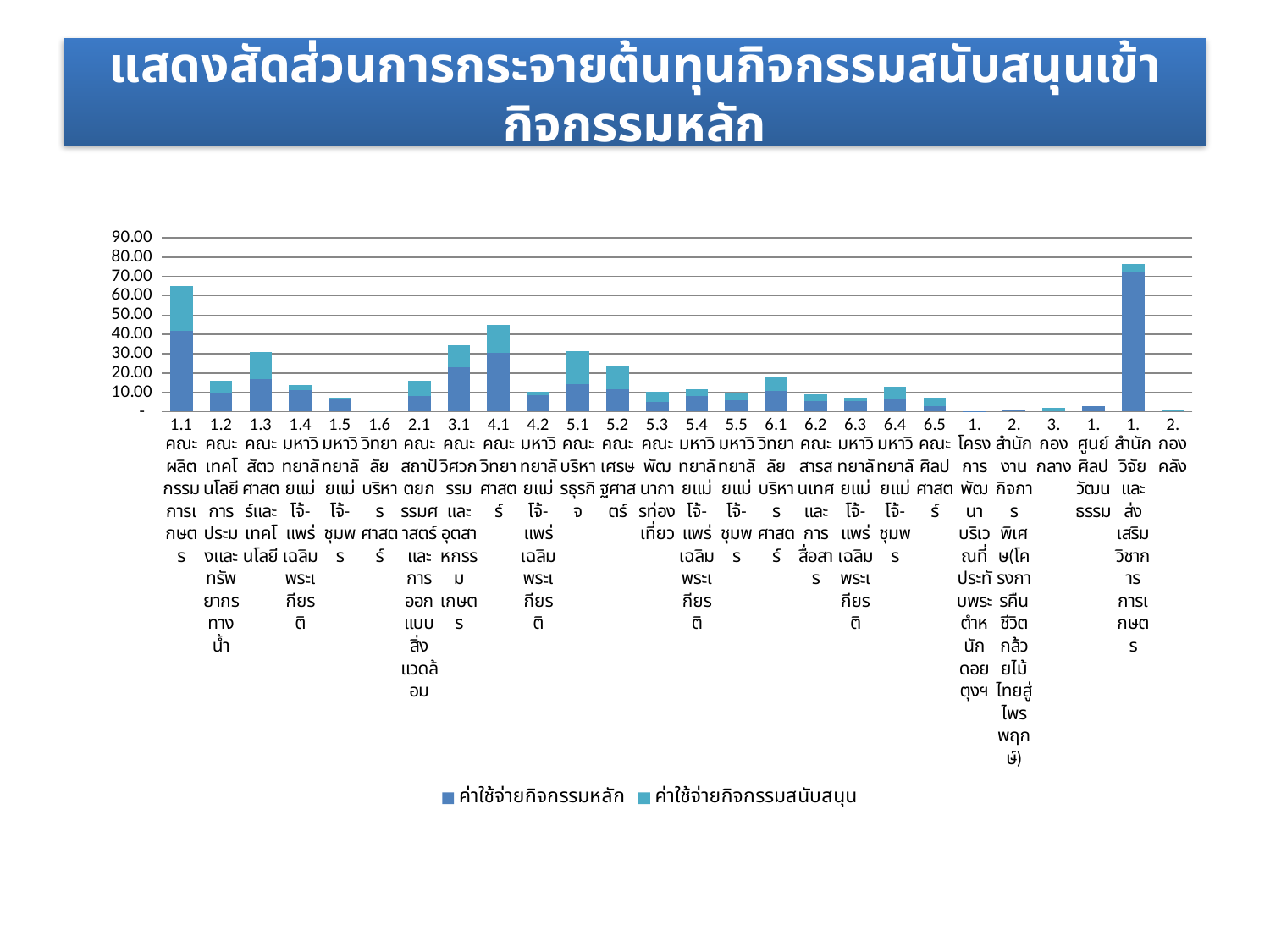
How many series does the legend list? 2 What kind of chart is shown on the slide? Stacked bar chart How many categories are plotted along the x axis? 26 Which has the taller total bar, category 1.1 or category 1.2? 1.1 What are the two series named in the legend? ค่าใช้จ่ายกิจกรรมหลัก and ค่าใช้จ่ายกิจกรรมสนับสนุน Is the total bar for category 1.1 (คณะผลิตกรรมการเกษตร) greater or less than 50.00? greater Is the total bar for category 1.5 (มหาวิทยาลัยแม่โจ้-ชุมพร) greater or less than 10.00? less Which has the taller total bar, category 3.1 or category 4.1? 4.1 Which category has the tallest bar? 1. สำนักวิจัยและส่งเสริมวิชาการการเกษตร What is the title of the chart? แสดงสัดส่วนการกระจายต้นทุนกิจกรรมสนับสนุนเข้ากิจกรรมหลัก